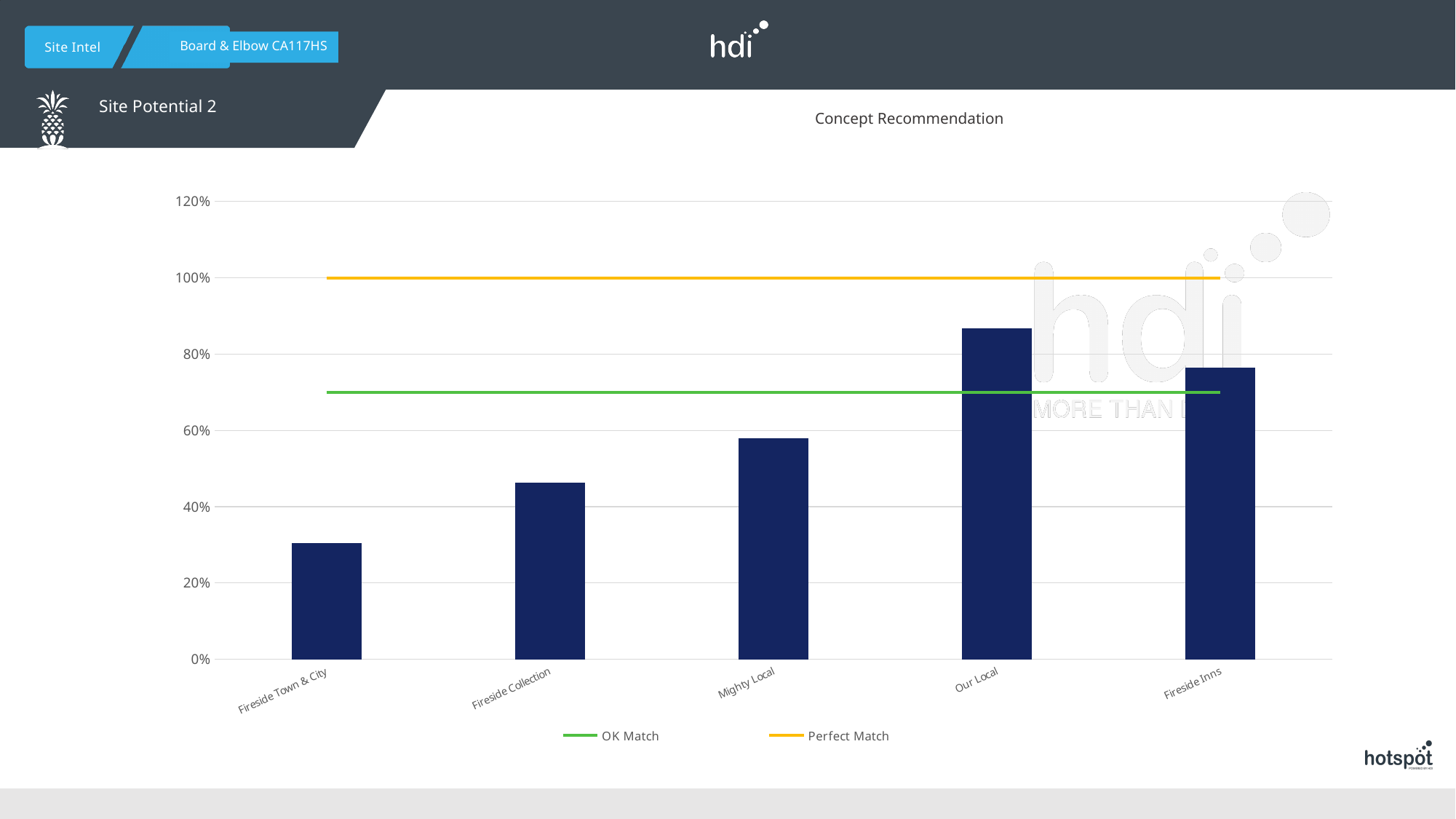
Is the value for Fireside Town & City greater or less than 40%? less Which concept has the lowest bar? Fireside Town & City Do the bar values rise or fall from Fireside Town & City through to Our Local? rise What is the title of the chart? Concept Recommendation How many entries does the chart legend list? 2 Which is larger, the value for Fireside Inns or the value for Mighty Local? Fireside Inns What kind of chart is shown on the slide? bar chart Which concept has the highest bar? Our Local Is the value for Our Local greater or less than 80%? greater How many concepts (bars) are plotted on the chart? 5 Is the value for Fireside Collection greater or less than 40%? greater At what percentage level is the Perfect Match line drawn? 100%